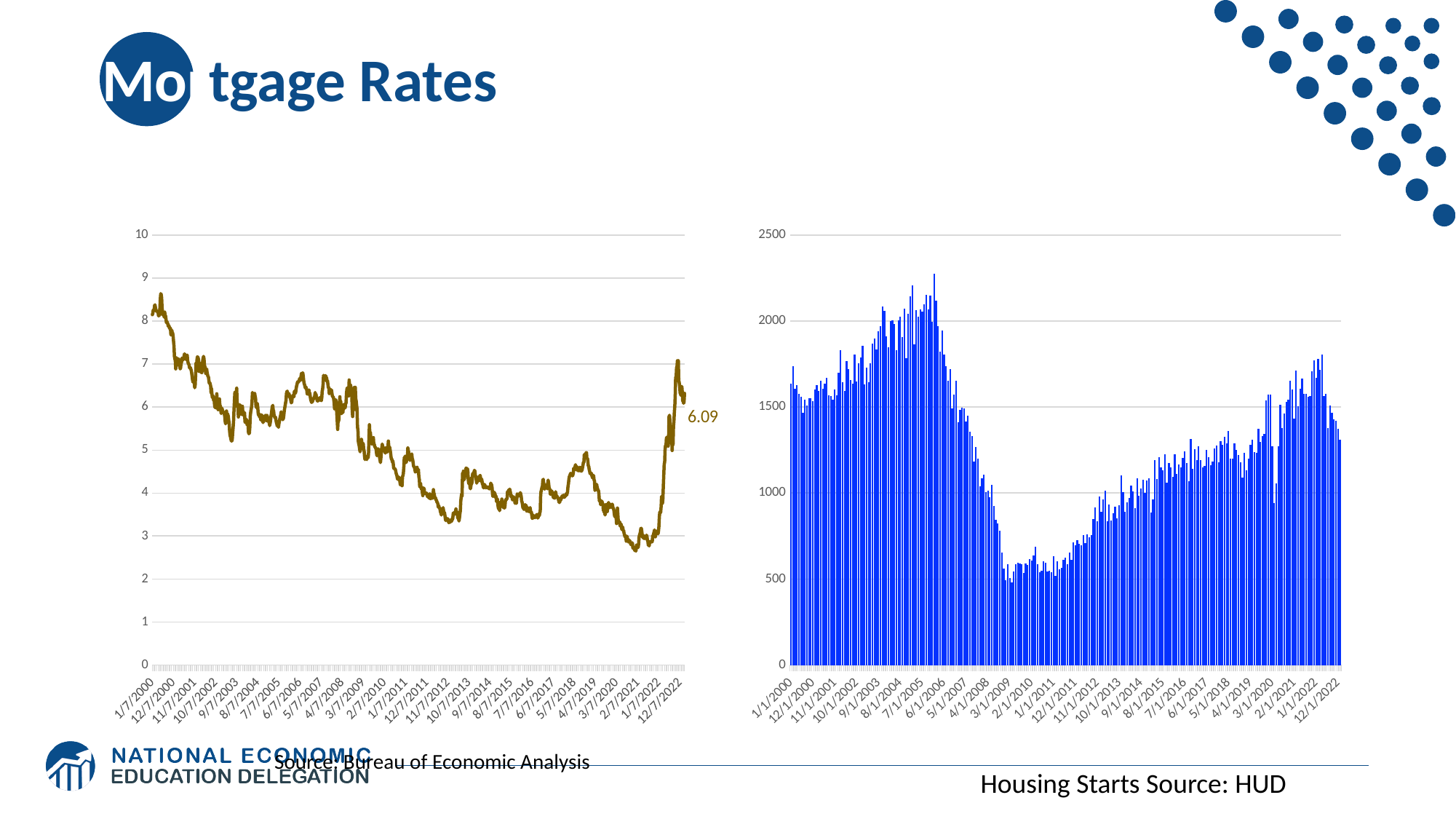
On the left chart, is the lowest point of the line, around early 2021, greater or less than 3? less On the left chart, is the value at the start of the series (1/7/2000) greater or less than 7? greater On the right chart, do the values overall rise or fall from 2006 to 2009? fall On the right chart, is the highest bar, around 2005-2006, greater or less than 2000? greater What is the highest tick shown on the vertical axis of the right chart? 2500 What kind of chart is the left chart on the slide? line chart On the left chart, which is larger: the value at the start of the series in 2000 or the final value of 6.09? the value at the start in 2000 On the left chart, what value is printed as the data label at the end of the line? 6.09 On the left chart, does the line overall rise or fall from 1/7/2000 to early 2021? fall What kind of chart is the right chart on the slide? bar chart